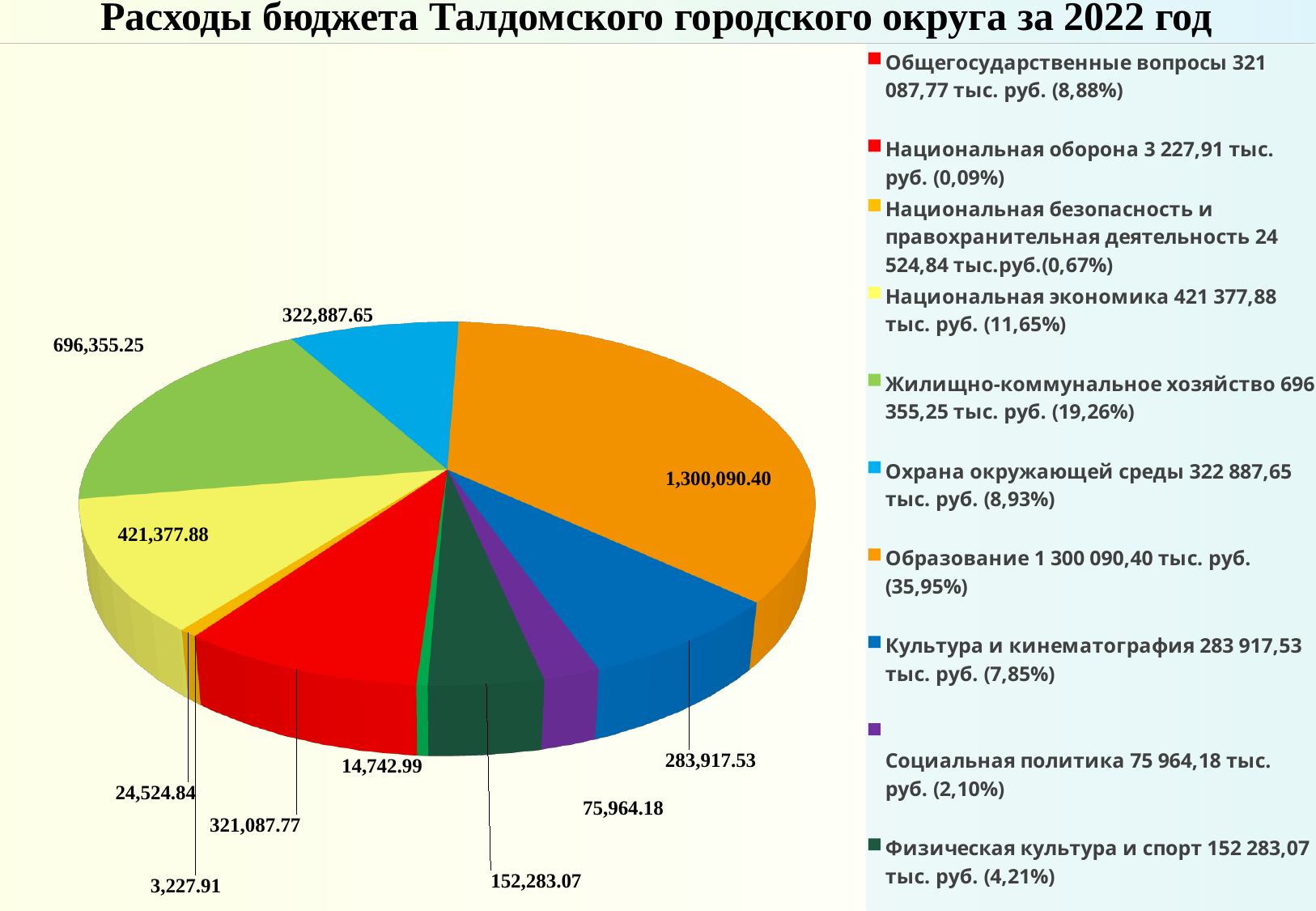
What share of the pie does Образование represent, according to the legend? 35,95% What is the value for Национальная оборона? 3,227.91 What is the difference between the values for Национальная экономика and Охрана окружающей среды? 98,490.23 Which is larger, the value for Культура и кинематография or the value for Социальная политика? Культура и кинематография What is the title of the chart? Расходы бюджета Талдомского городского округа за 2022 год Which category has the largest slice of the pie? Образование What is the value for Жилищно-коммунальное хозяйство? 696,355.25 How many slices does the pie chart have? 11 What is the value for Образование? 1,300,090.40 Which category has the smallest slice of the pie? Национальная оборона What kind of chart is shown on the slide? pie chart What is the difference between the values for Образование and Жилищно-коммунальное хозяйство? 603,735.15